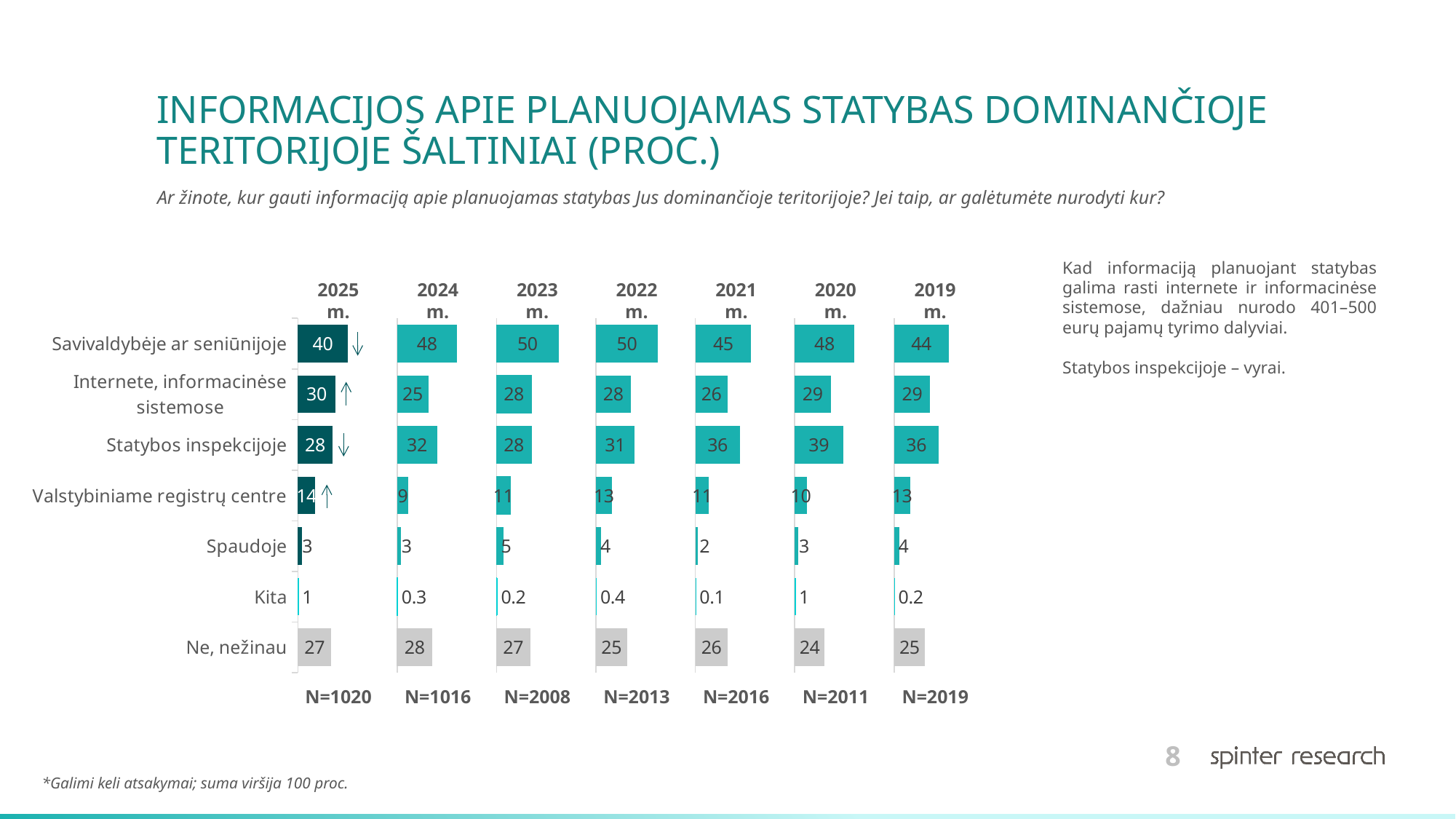
What is the value for "Statybos inspekcijoje" in the 2020 m. chart? 39 What is the difference between the "Savivaldybėje ar seniūnijoje" values in the 2024 m. and 2025 m. charts? 8 Which is larger in the 2019 m. chart: "Statybos inspekcijoje" or "Internete, informacinėse sistemose"? Statybos inspekcijoje In the 2022 m. chart, which category has the lowest value? Kita How many categories are listed on the left of the charts? 7 How many yearly charts are shown on the slide? 7 What is the value for "Ne, nežinau" in the 2024 m. chart? 28 What is the sample size (N) shown under the 2025 m. chart? N=1020 In the 2023 m. chart, which category has the highest value? Savivaldybėje ar seniūnijoje What kind of chart is used on this slide? Bar chart What is the value for "Kita" in the 2021 m. chart? 0.1 What is the value for "Savivaldybėje ar seniūnijoje" in the 2025 m. chart? 40